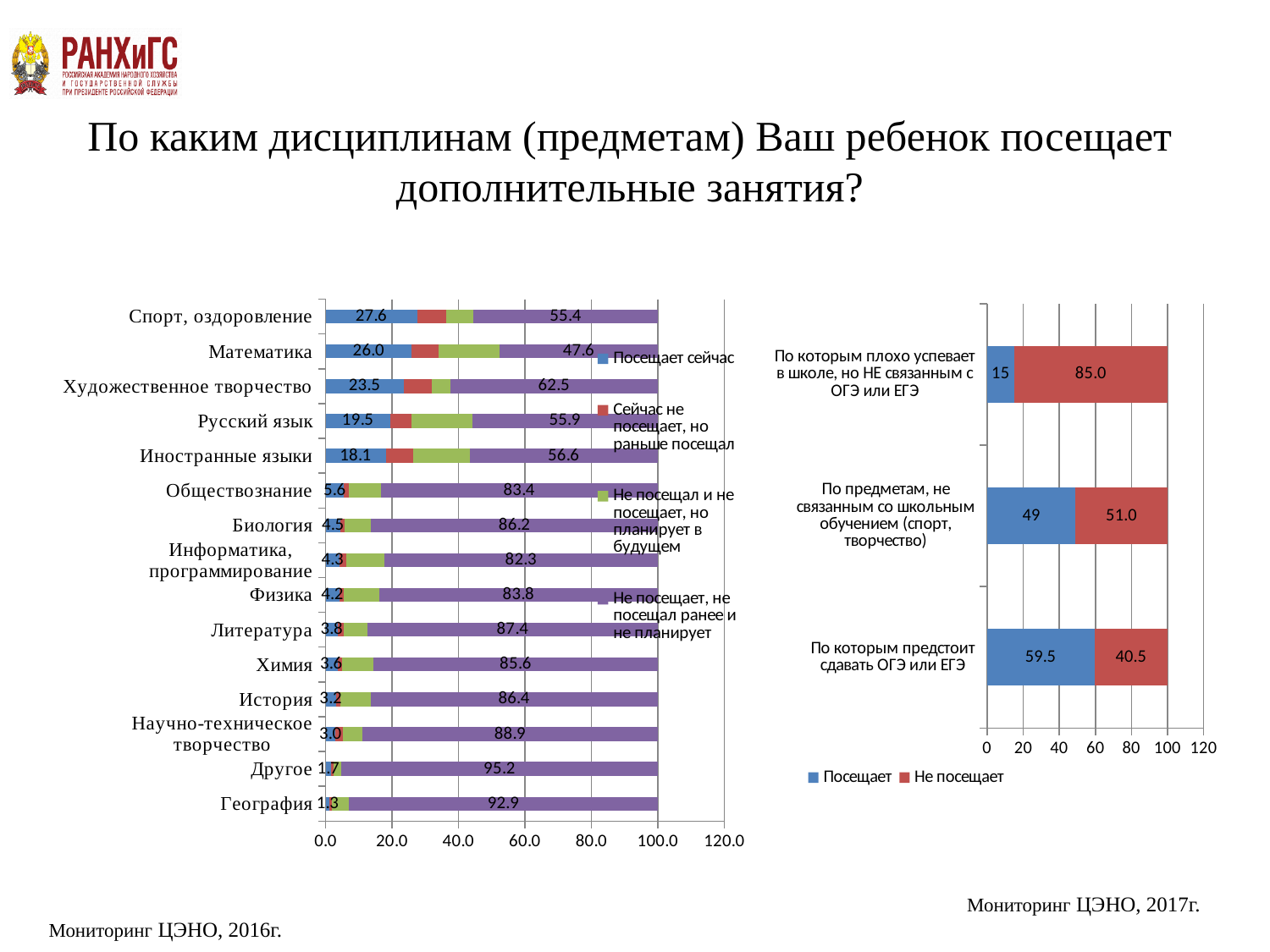
In the left chart, which category has the lowest value for 'Посещает сейчас'? География In the left chart, which category has the highest value for 'Посещает сейчас'? Спорт, оздоровление In the left chart, what is the value of 'Не посещает, не посещал ранее и не планирует' for 'Другое'? 95.2 In the left chart, what is the value of 'Посещает сейчас' for 'Спорт, оздоровление'? 27.6 In the right chart, what is the 'Посещает' value for 'По которым предстоит сдавать ОГЭ или ЕГЭ'? 59.5 What kind of chart is the right chart? Stacked bar chart In the left chart, which is larger for 'Не посещает, не посещал ранее и не планирует': 'Биология' or 'Физика'? Биология How many categories are shown in the left chart? 15 In the right chart, which category has the highest 'Не посещает' value? По которым плохо успевает в школе, но НЕ связанным с ОГЭ или ЕГЭ In the right chart, what is the total of the stacked bar for 'По которым плохо успевает в школе, но НЕ связанным с ОГЭ или ЕГЭ'? 100.0 How many series does the legend of the left chart list? 4 In the left chart, what is the difference between the 'Посещает сейчас' values for 'Математика' and 'Русский язык'? 6.5